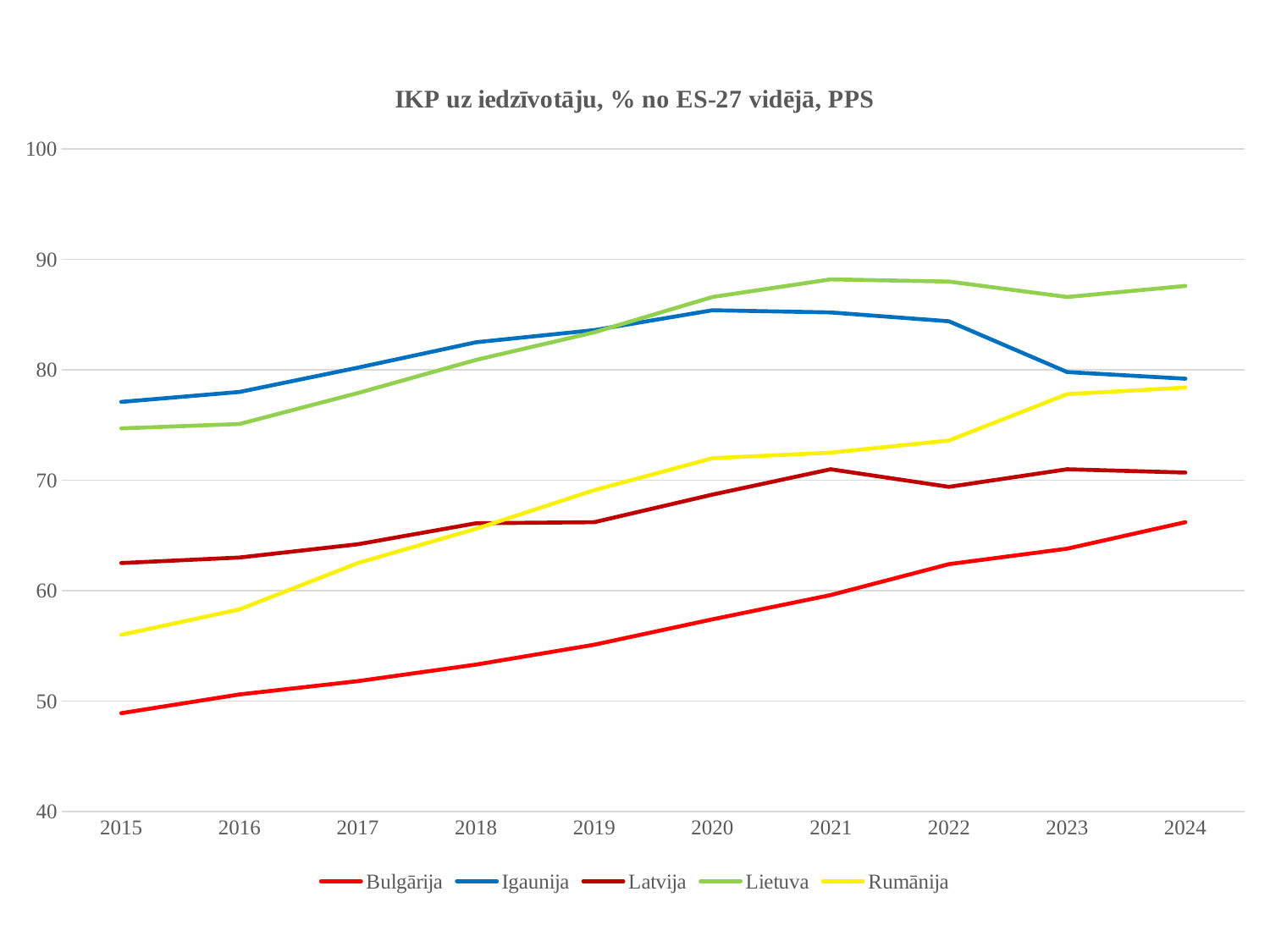
What is the title of the chart? IKP uz iedzīvotāju, % no ES-27 vidējā, PPS Does the value for Bulgārija rise or fall from 2015 to 2024? rise What kind of chart is shown on the slide? line chart How many series does the legend list? 5 Is the value for Lietuva in 2024 greater or less than 80? greater Which country has the lowest value in 2024? Bulgārija Which country has the highest value in 2015? Igaunija Which country has the highest value in 2024? Lietuva In 2022, which is larger: the value for Igaunija or the value for Lietuva? Lietuva Is the value for Rumānija in 2015 greater or less than 60? less Is the value for Bulgārija in 2015 greater or less than 50? less How many years are plotted along the x axis? 10